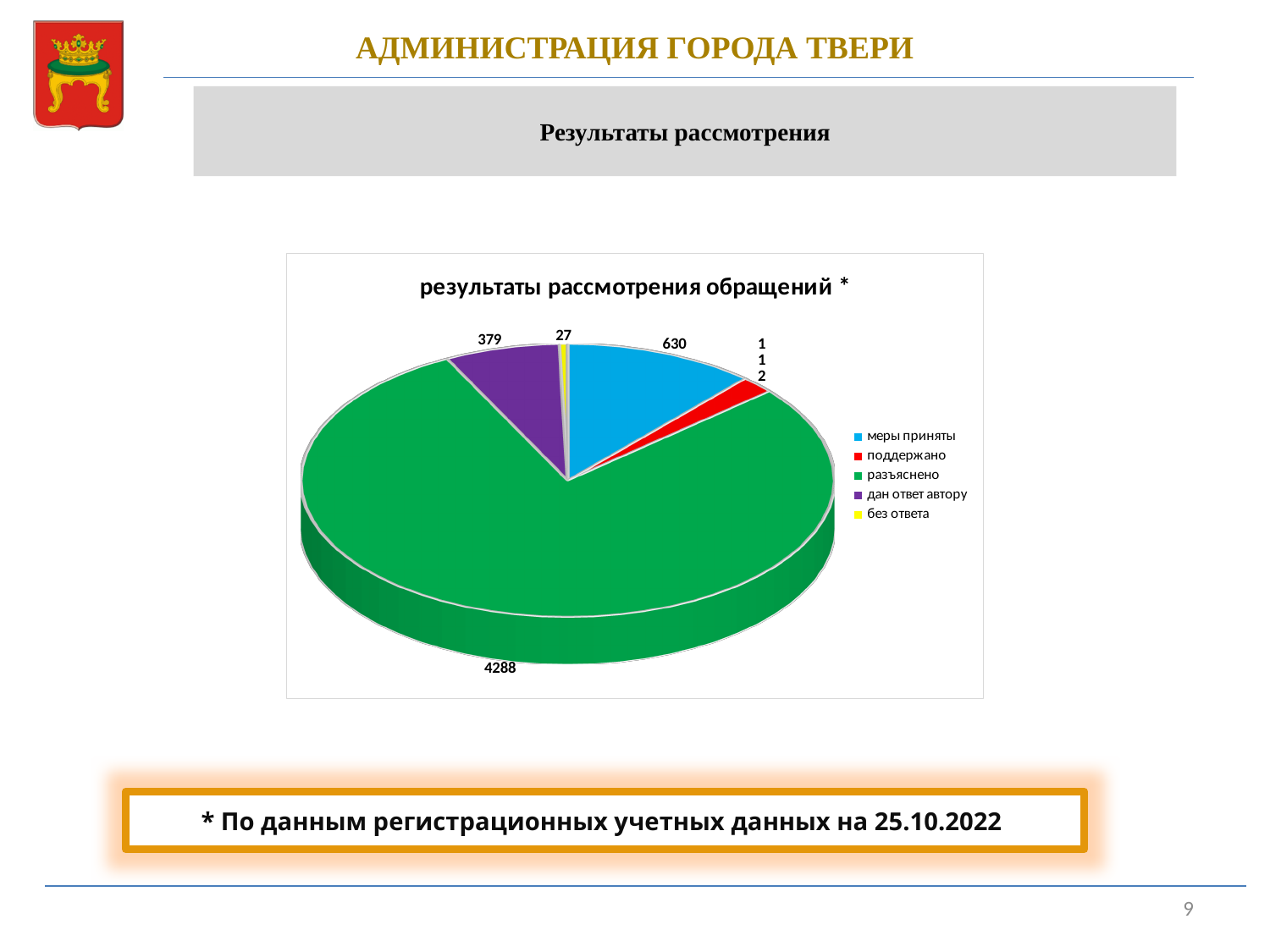
Which is larger: the value for "меры приняты" or the value for "дан ответ автору"? меры приняты How many categories does the legend of the pie chart list? 5 What is the title of the pie chart? результаты рассмотрения обращений * What is the value for "меры приняты" in the pie chart? 630 What kind of chart is shown on the slide? pie chart What is the value for "дан ответ автору" in the pie chart? 379 What is the difference between the values for "меры приняты" and "дан ответ автору"? 251 What is the value for "без ответа" in the pie chart? 27 Which category has the largest slice in the pie chart? разъяснено Which category has the smallest slice in the pie chart? без ответа What is the difference between the values for "разъяснено" and "меры приняты"? 3658 What is the value for "разъяснено" in the pie chart? 4288